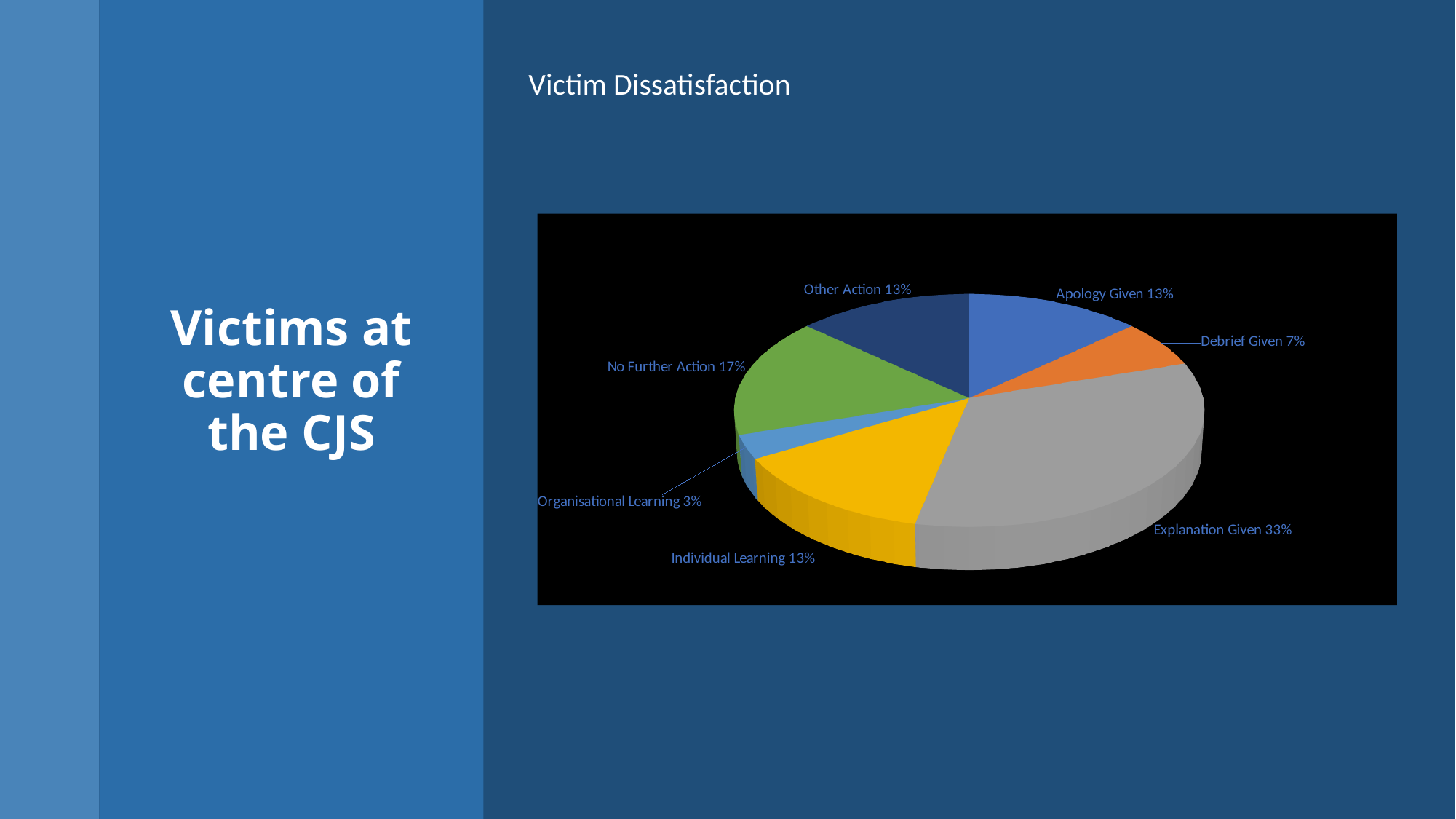
What kind of chart is shown on the slide? Pie chart Which is larger, the share for Debrief Given or the share for Apology Given? Apology Given Which category has the smallest slice of the pie? Organisational Learning What colour is the Explanation Given slice? Grey What share of the pie does No Further Action have? 17% How many categories are shown in the pie chart? 7 What share of the pie does Debrief Given have? 7% What is the difference in percentage points between Explanation Given and No Further Action? 16 Which category has the largest slice of the pie? Explanation Given What is the title of the chart? Victim Dissatisfaction What share of the pie does Explanation Given have? 33%